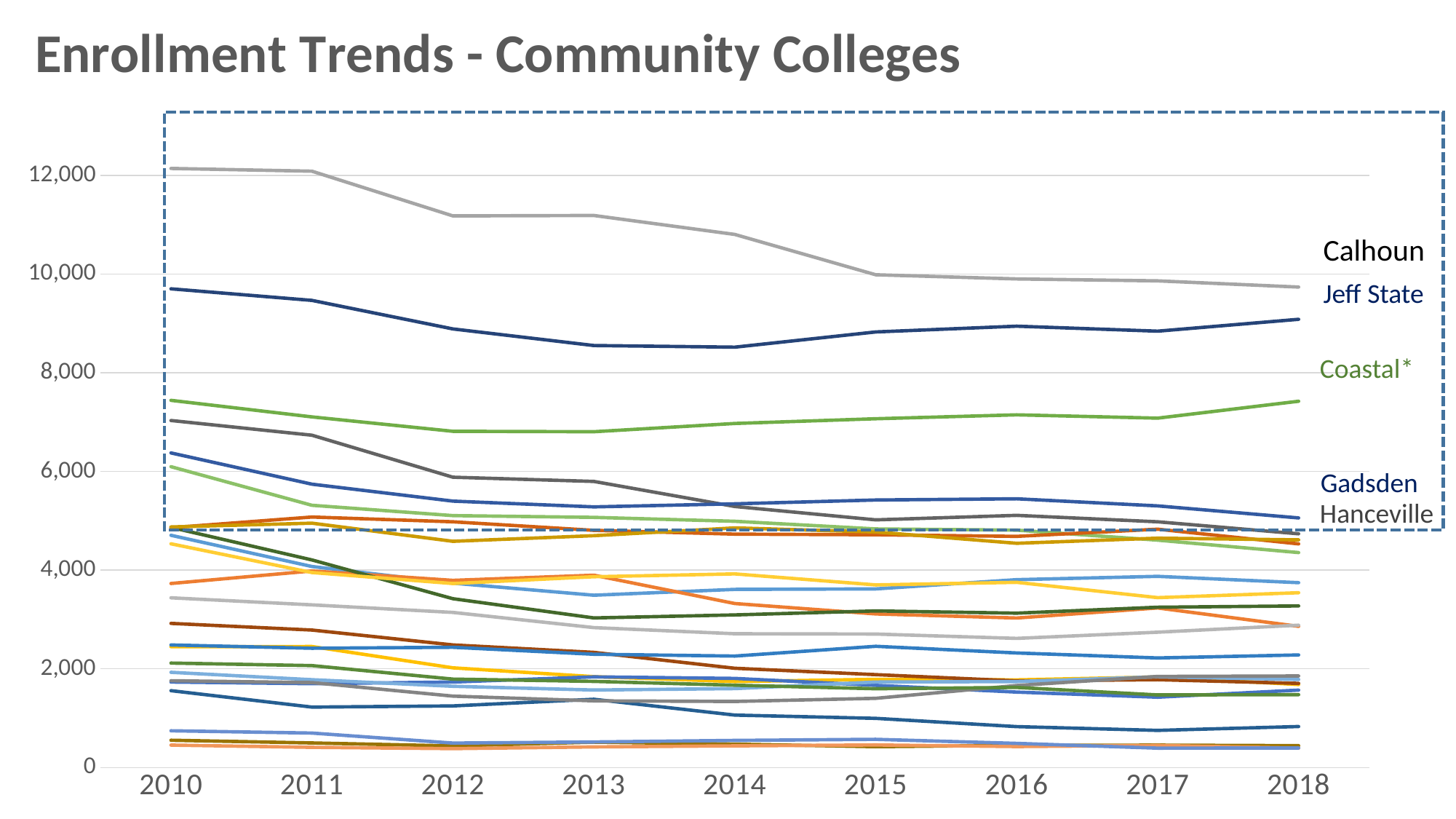
What kind of chart is shown on the slide? line chart Is the value for Coastal* in 2018 greater or less than 8,000? less Is the value for Jeff State in 2010 greater or less than 8,000? greater Is the value for Hanceville in 2010 greater or less than 6,000? greater Which labeled college has the highest enrollment in 2018? Calhoun What is the title of the chart? Enrollment Trends - Community Colleges Does Calhoun's enrollment rise or fall from 2010 to 2018? fall Does Hanceville's enrollment rise or fall from 2010 to 2018? fall In 2018, which is larger: Calhoun or Jeff State? Calhoun How many years are shown along the x axis? 9